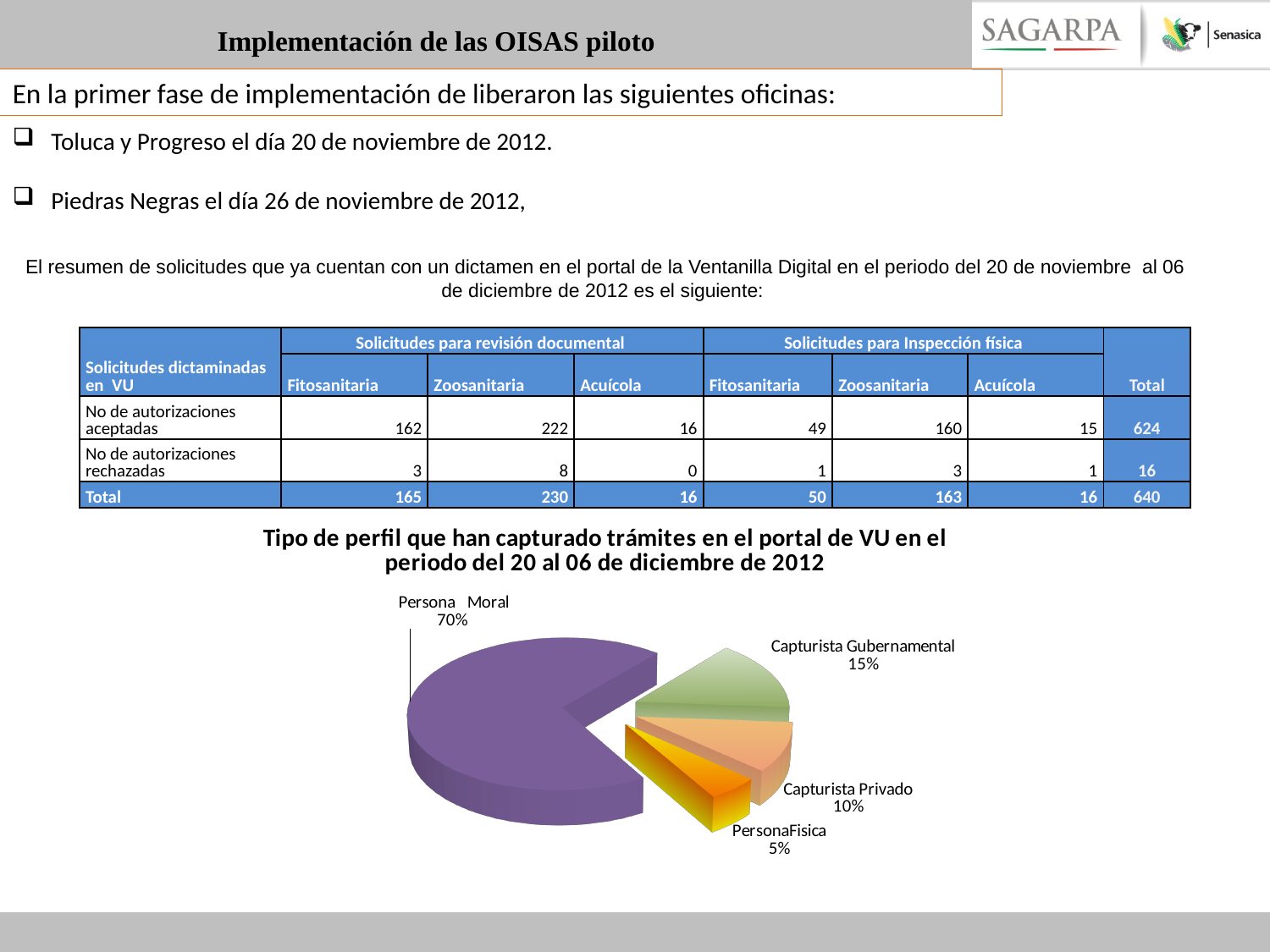
What is the value shown for Capturista Gubernamental? 15% What is the difference in percentage points between Persona Moral and Capturista Gubernamental? 55 Which category has the smallest slice of the pie? PersonaFisica What kind of chart is shown on the slide? Pie chart What colour is the Persona Moral slice of the pie? Purple Which category has the largest slice of the pie? Persona Moral What is the value shown for PersonaFisica? 5% What is the difference in percentage points between Capturista Privado and PersonaFisica? 5 How many slices does the pie chart have? 4 Which is larger, Capturista Gubernamental or Capturista Privado? Capturista Gubernamental What is the value shown for Capturista Privado? 10% What share of the pie does Persona Moral have? 70%